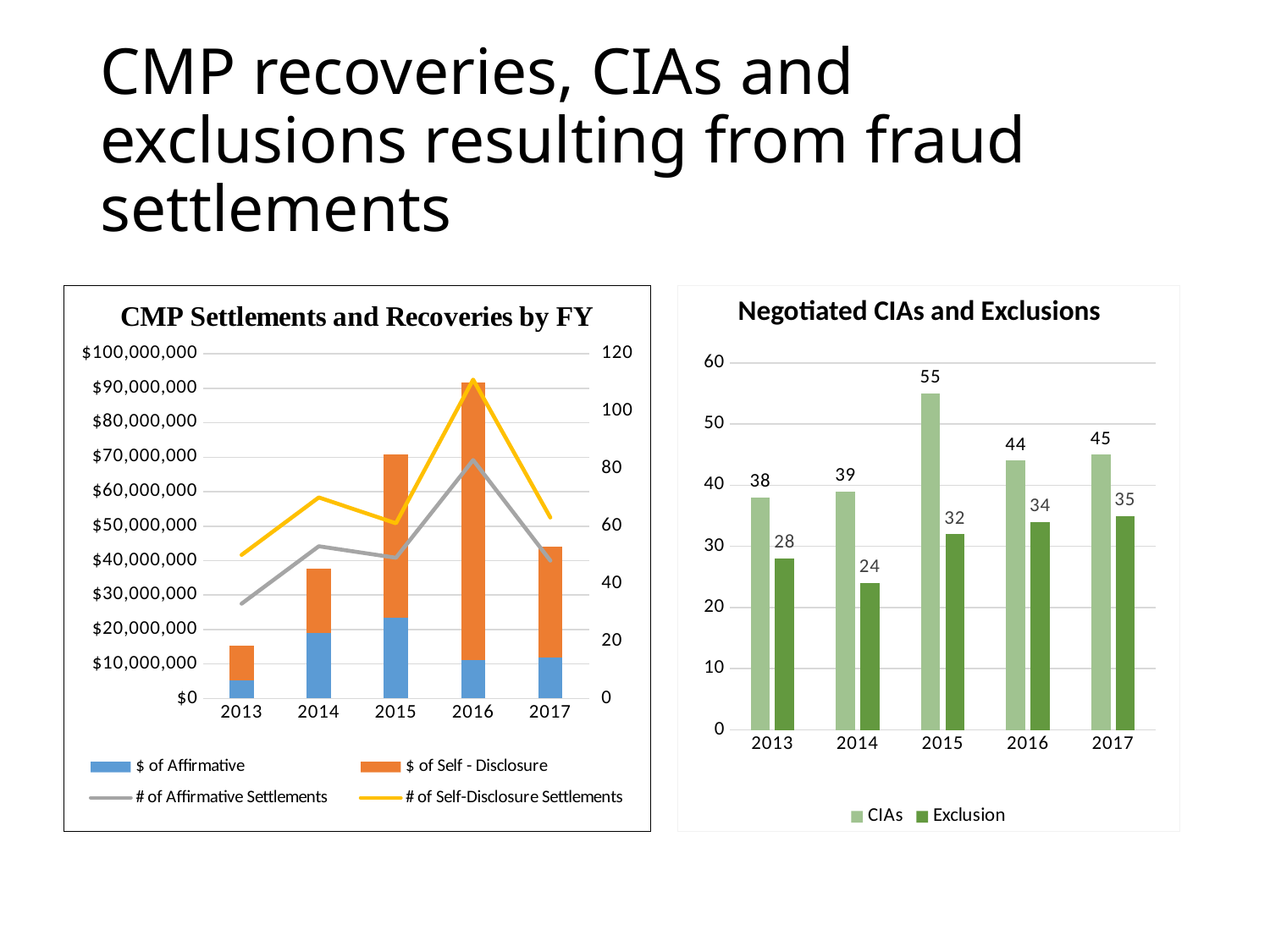
In the Negotiated CIAs and Exclusions chart, which year has the highest number of CIAs? 2015 In the Negotiated CIAs and Exclusions chart, how many years are shown on the x axis? 5 In the CMP Settlements and Recoveries by FY chart, is the total stacked bar value for 2013 greater or less than $20,000,000? less In the Negotiated CIAs and Exclusions chart, what is the difference between CIAs and Exclusions in 2015? 23 In the Negotiated CIAs and Exclusions chart, what is the value for CIAs in 2015? 55 In the Negotiated CIAs and Exclusions chart, how many series does the legend list? 2 What kind of chart is the Negotiated CIAs and Exclusions chart? Bar chart In the CMP Settlements and Recoveries by FY chart, how many series does the legend list? 4 In the CMP Settlements and Recoveries by FY chart, is the total stacked bar value for 2016 greater or less than $80,000,000? greater In the Negotiated CIAs and Exclusions chart, which is larger in 2017: CIAs or Exclusion? CIAs In the Negotiated CIAs and Exclusions chart, what is the value for Exclusion in 2014? 24 In the Negotiated CIAs and Exclusions chart, which year has the lowest number of Exclusions? 2014